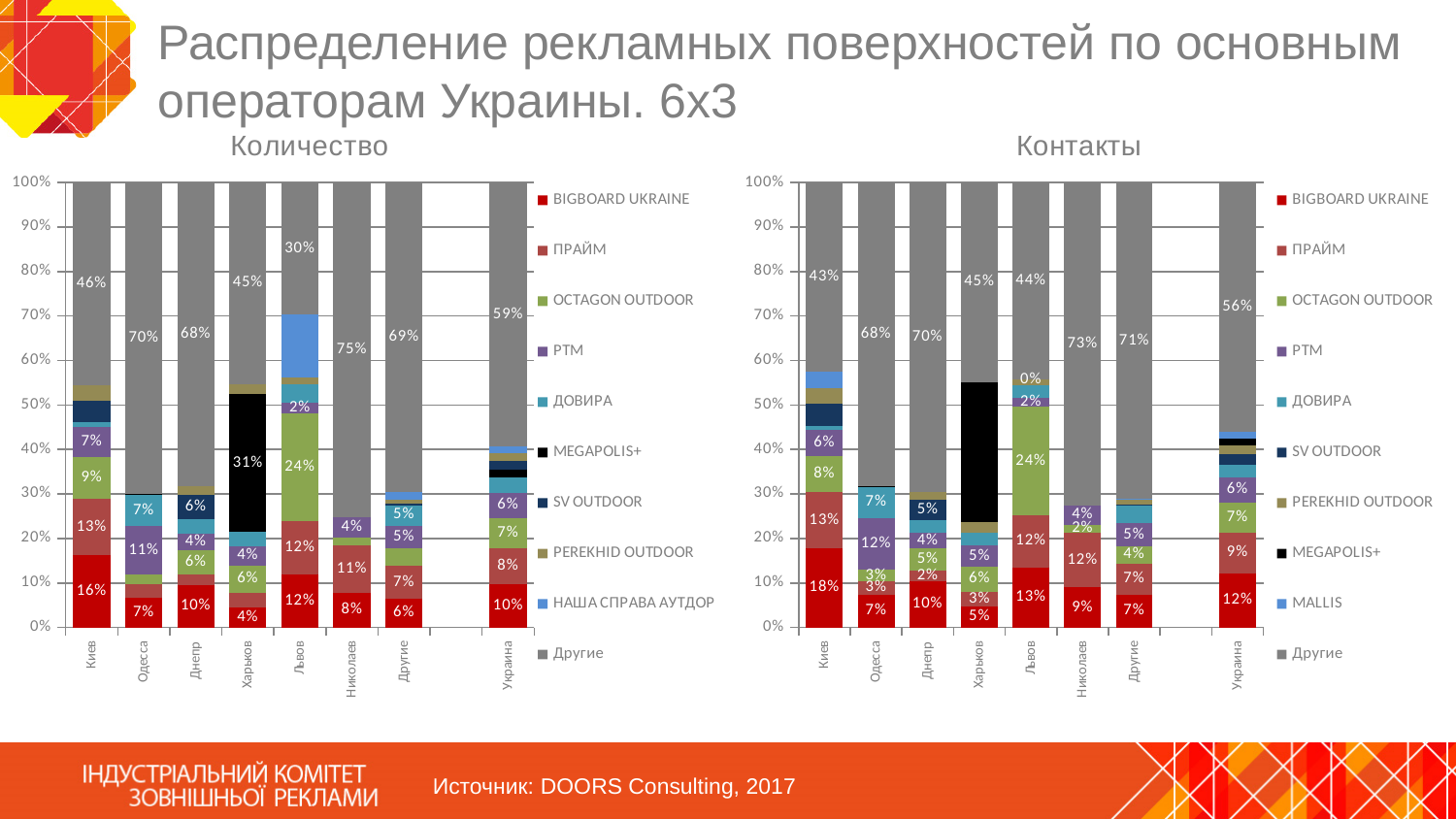
In the "Количество" chart, which city has the highest "Другие" share? Николаев In the "Контакты" chart, what is the value of BIGBOARD UKRAINE for Киев? 18% In the "Контакты" chart, what is the difference between the BIGBOARD UKRAINE values for Киев and Одесса? 11 percentage points In the "Количество" chart, which is larger: the BIGBOARD UKRAINE value for Киев or for Львов? Киев Which legend entry appears in the "Контакты" chart but not in the "Количество" chart? MALLIS How many series does the legend of the "Количество" chart list? 10 In the "Количество" chart, which category has the lowest "Другие" share? Львов In the "Количество" chart, what is the MEGAPOLIS+ value for Харьков? 31% What type of chart is the "Количество" chart on the left? Stacked bar chart In the "Контакты" chart, what is the OCTAGON OUTDOOR value for Львов? 24% In the "Количество" chart, what is the value of "Другие" for Львов? 30% How many categories are shown on the x axis of the "Контакты" chart? 8